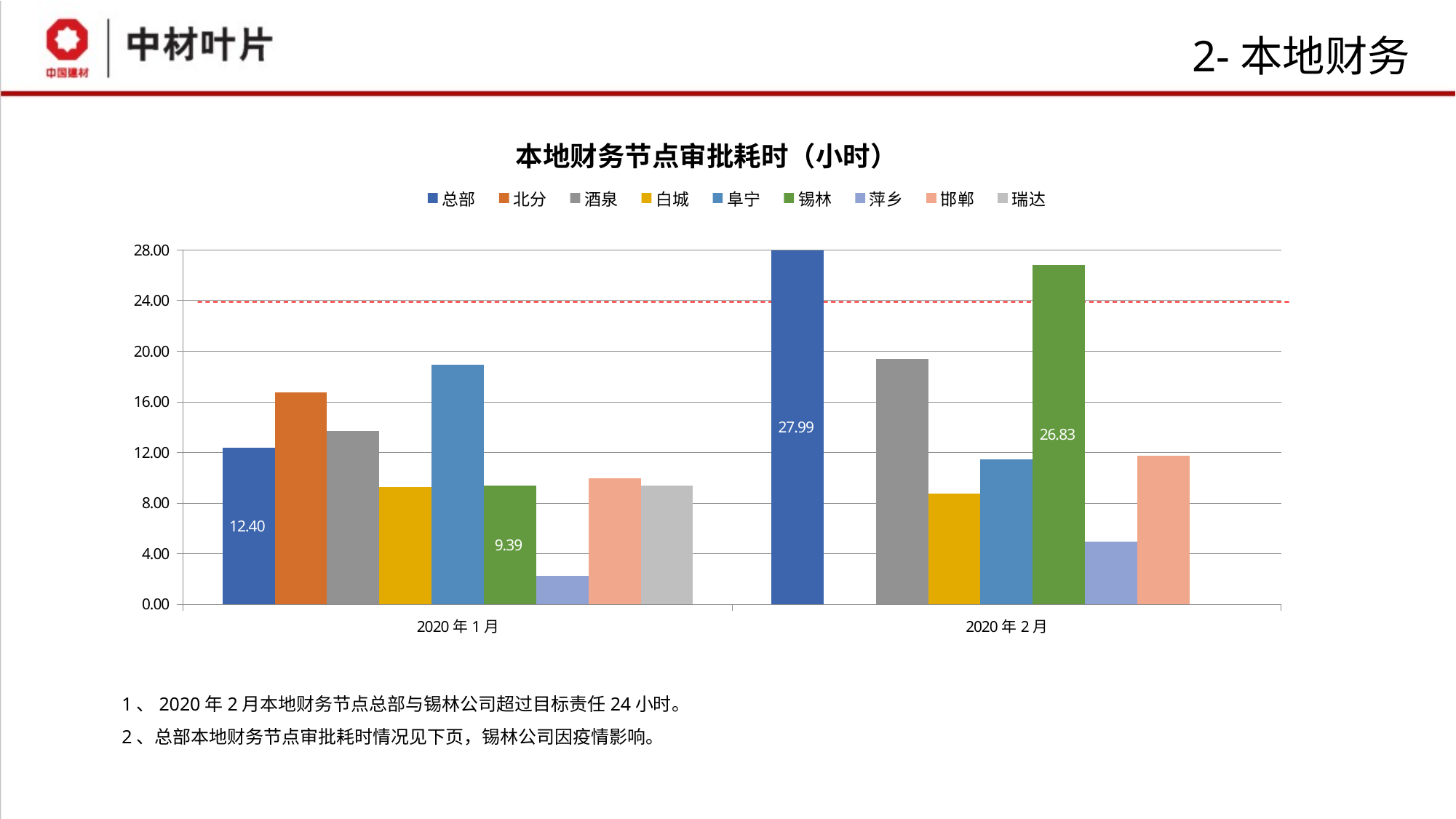
Is the value for 萍乡 in 2020年1月 greater or less than 4.00? less What kind of chart is shown on the slide? Bar chart What is the value for 总部 in 2020年1月? 12.40 Which series has the lowest value in 2020年1月? 萍乡 Is the value for 阜宁 in 2020年1月 greater or less than 16.00? greater How many series does the legend list? 9 What is the value for 锡林 in 2020年2月? 26.83 By how much did the value for 总部 increase from 2020年1月 to 2020年2月? 15.59 Which series has the highest value in 2020年1月? 阜宁 What is the value for 总部 in 2020年2月? 27.99 In 2020年2月, which is larger, the value for 总部 or the value for 锡林? 总部 What is the value for 锡林 in 2020年1月? 9.39